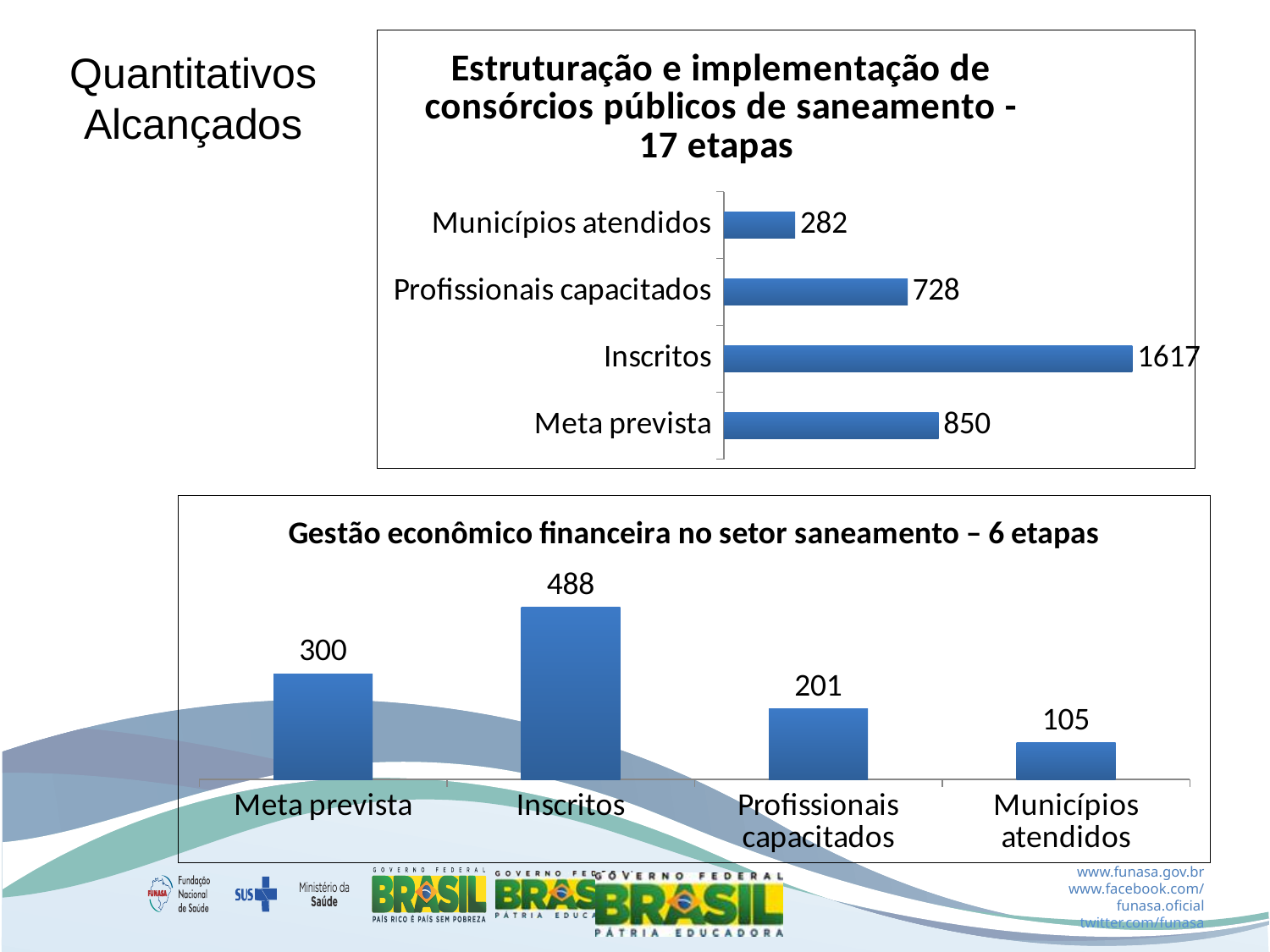
In the top chart 'Estruturação e implementação de consórcios públicos de saneamento - 17 etapas', what is the value for Municípios atendidos? 282 In the bottom chart 'Gestão econômico financeira no setor saneamento – 6 etapas', what is the value for Profissionais capacitados? 201 In the bottom chart 'Gestão econômico financeira no setor saneamento – 6 etapas', what is the value for Inscritos? 488 In the bottom chart 'Gestão econômico financeira no setor saneamento – 6 etapas', how many categories are shown? 4 In the bottom chart 'Gestão econômico financeira no setor saneamento – 6 etapas', which category has the lowest value? Municípios atendidos In the top chart 'Estruturação e implementação de consórcios públicos de saneamento - 17 etapas', what is the difference between Meta prevista and Profissionais capacitados? 122 In the top chart 'Estruturação e implementação de consórcios públicos de saneamento - 17 etapas', which category has the lowest value? Municípios atendidos In the top chart 'Estruturação e implementação de consórcios públicos de saneamento - 17 etapas', what is the value for Inscritos? 1617 In the bottom chart 'Gestão econômico financeira no setor saneamento – 6 etapas', what is the difference between Inscritos and Meta prevista? 188 In the top chart 'Estruturação e implementação de consórcios públicos de saneamento - 17 etapas', what kind of chart is shown? Bar chart In the bottom chart 'Gestão econômico financeira no setor saneamento – 6 etapas', which is larger, Meta prevista or Municípios atendidos? Meta prevista In the top chart 'Estruturação e implementação de consórcios públicos de saneamento - 17 etapas', which category has the highest value? Inscritos